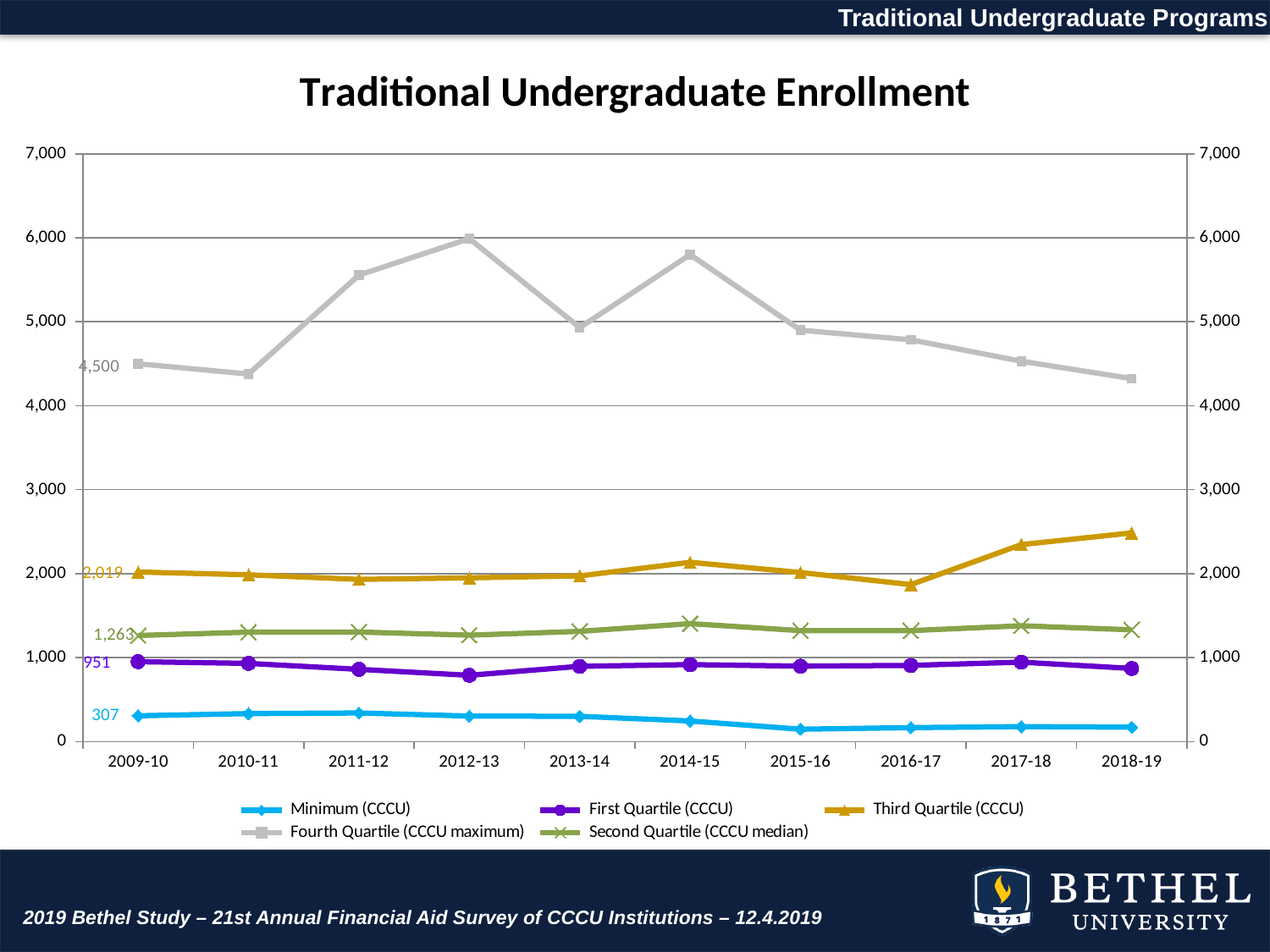
What is the difference between the Fourth Quartile and Third Quartile values in 2009-10? 2,481 Is the Fourth Quartile (CCCU maximum) value for 2018-19 greater or less than 5,000? less What is the Second Quartile (CCCU median) value for 2009-10? 1,263 In which year does the Fourth Quartile (CCCU maximum) series reach its highest value? 2012-13 What is the Fourth Quartile (CCCU maximum) value for 2009-10? 4,500 Is the Fourth Quartile (CCCU maximum) value for 2012-13 greater or less than 5,000? greater How many series does the legend list? 5 What is the Minimum (CCCU) value for 2009-10? 307 What is the difference between the First Quartile and Minimum values in 2009-10? 644 In which year does the Third Quartile (CCCU) series reach its highest value? 2018-19 What kind of chart is shown on the slide? line chart What is the Third Quartile (CCCU) value for 2009-10? 2,019